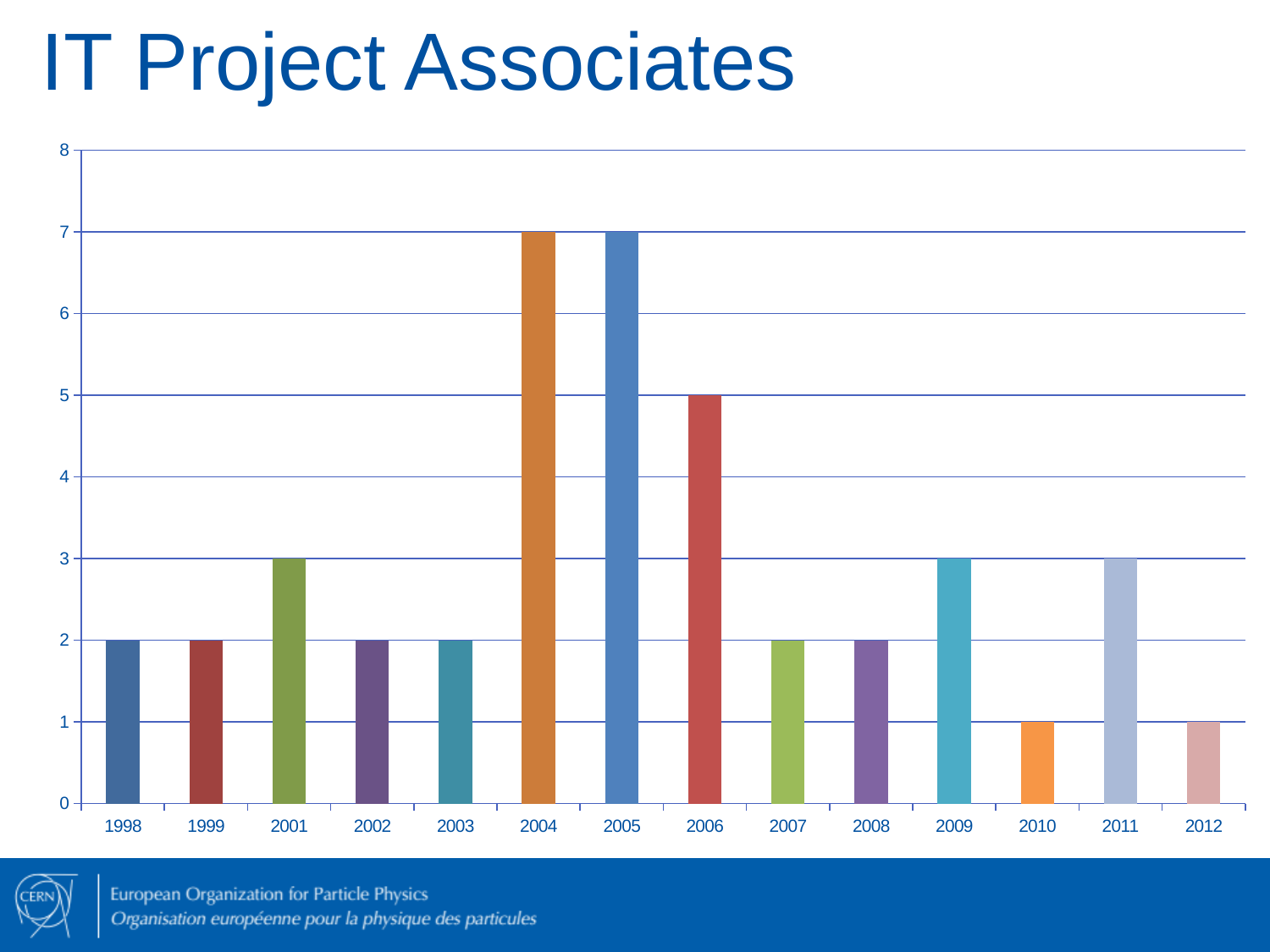
Which is larger, the value for 2006 or the value for 2009? 2006 What is the value for 2001? 3 Do the values rise or fall from 2005 to 2007? fall What is the title of the slide containing the chart? IT Project Associates What is the value for 2006? 5 Is the value for 2004 greater or less than 4? greater What is the highest value reached by any bar in the chart? 7 How many years are shown on the x axis? 14 What is the value for 2004? 7 What is the value for 2010? 1 What kind of chart is shown on the slide? bar chart What is the difference between the values for 2005 and 2006? 2